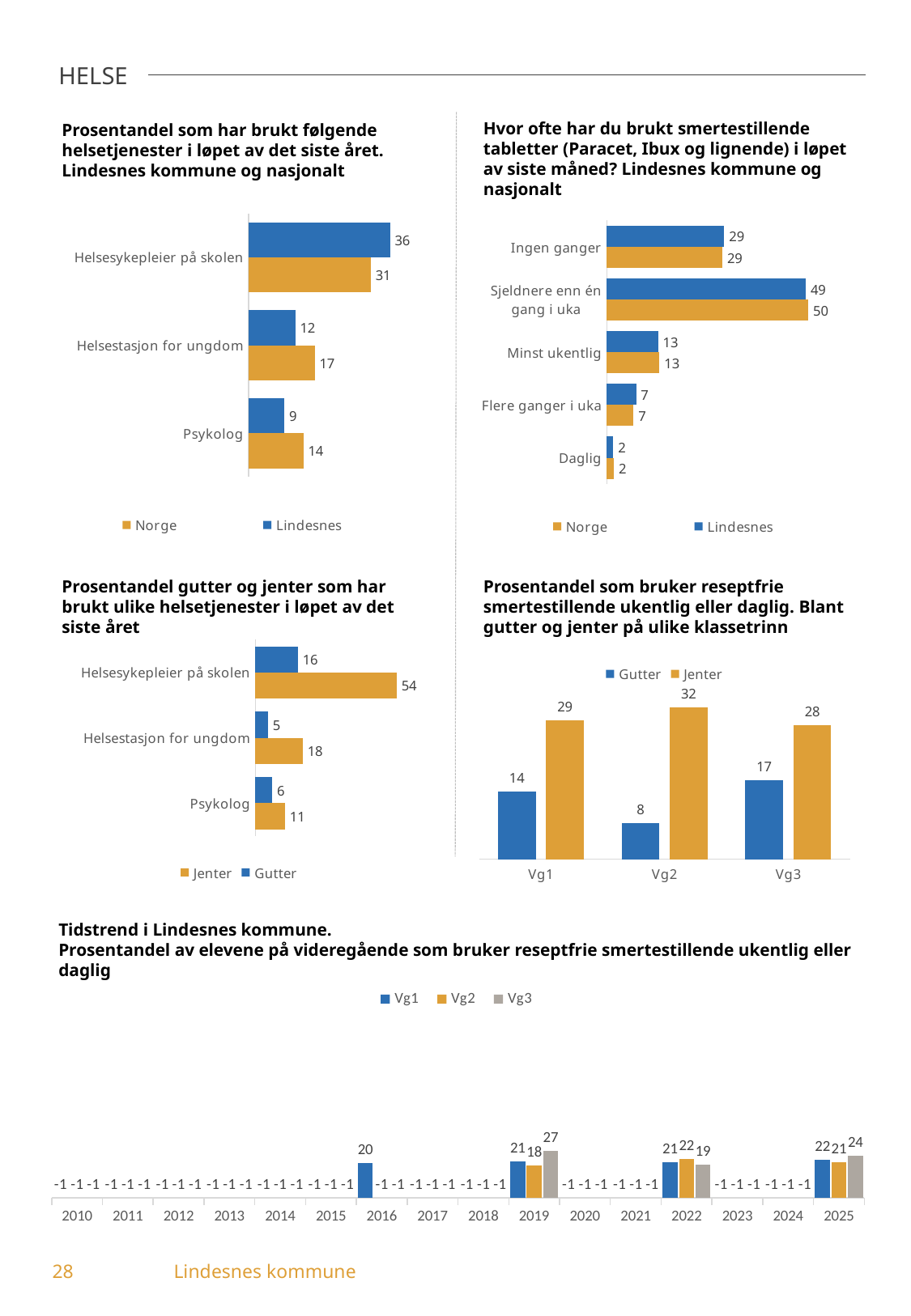
In the chart 'Prosentandel som har brukt følgende helsetjenester i løpet av det siste året', what is the difference between the Norge and Lindesnes values for 'Psykolog'? 5 How many categories are shown in the chart 'Hvor ofte har du brukt smertestillende tabletter'? 5 In the chart 'Hvor ofte har du brukt smertestillende tabletter', what is the Norge value for 'Daglig'? 2 In the chart 'Prosentandel som bruker reseptfrie smertestillende ukentlig eller daglig', what is the value for Jenter in Vg2? 32 In the chart 'Prosentandel som har brukt følgende helsetjenester i løpet av det siste året', what is the value for Lindesnes for 'Helsesykepleier på skolen'? 36 In the chart 'Tidstrend i Lindesnes kommune', what is the value for Vg3 in 2019? 27 How many series does the legend list in the chart 'Tidstrend i Lindesnes kommune'? 3 What type of chart is 'Prosentandel som bruker reseptfrie smertestillende ukentlig eller daglig'? Bar chart In the chart 'Prosentandel gutter og jenter som har brukt ulike helsetjenester', which category has the lowest value for Gutter? Helsestasjon for ungdom In the chart 'Prosentandel gutter og jenter som har brukt ulike helsetjenester', what is the value for Jenter for 'Helsesykepleier på skolen'? 54 In the chart 'Hvor ofte har du brukt smertestillende tabletter', which category has the highest value for Lindesnes? Sjeldnere enn én gang i uka In the chart 'Prosentandel som bruker reseptfrie smertestillende ukentlig eller daglig', which is larger for Vg3: Gutter or Jenter? Jenter